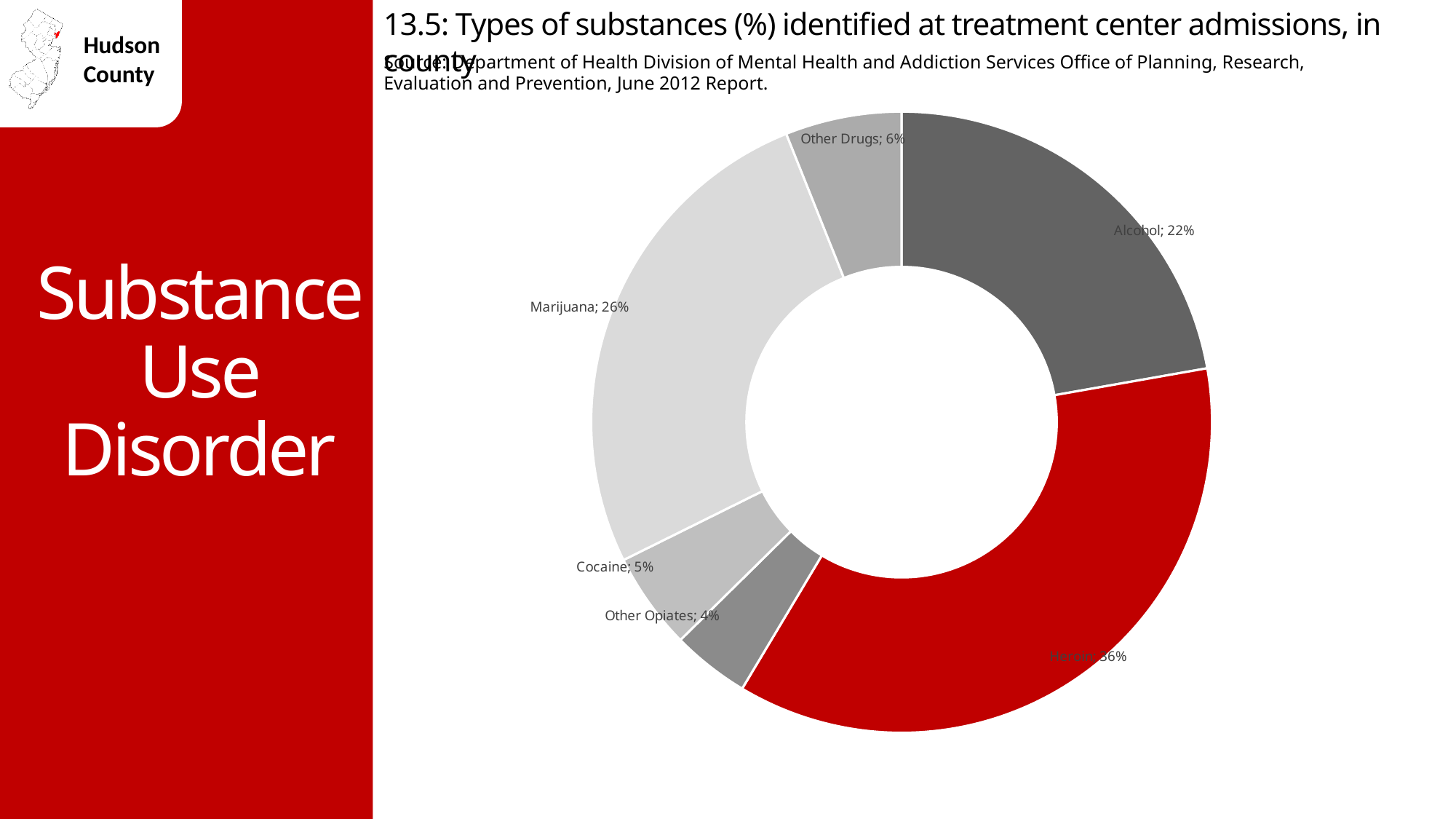
What percentage is shown for Alcohol? 22% How many substance categories are shown in the chart? 6 What percentage of treatment center admissions is identified as Heroin? 36% What is the difference in percentage points between Marijuana and Cocaine? 21 What percentage is shown for Marijuana? 26% Which substance has the largest share of admissions? Heroin What is the difference in percentage points between Heroin and Alcohol? 14 What percentage is shown for Other Opiates? 4% What type of chart is shown on the slide? Doughnut (pie) chart Which has a larger share, Other Drugs or Cocaine? Other Drugs Which has a larger share, Marijuana or Alcohol? Marijuana Which substance has the smallest share of admissions? Other Opiates